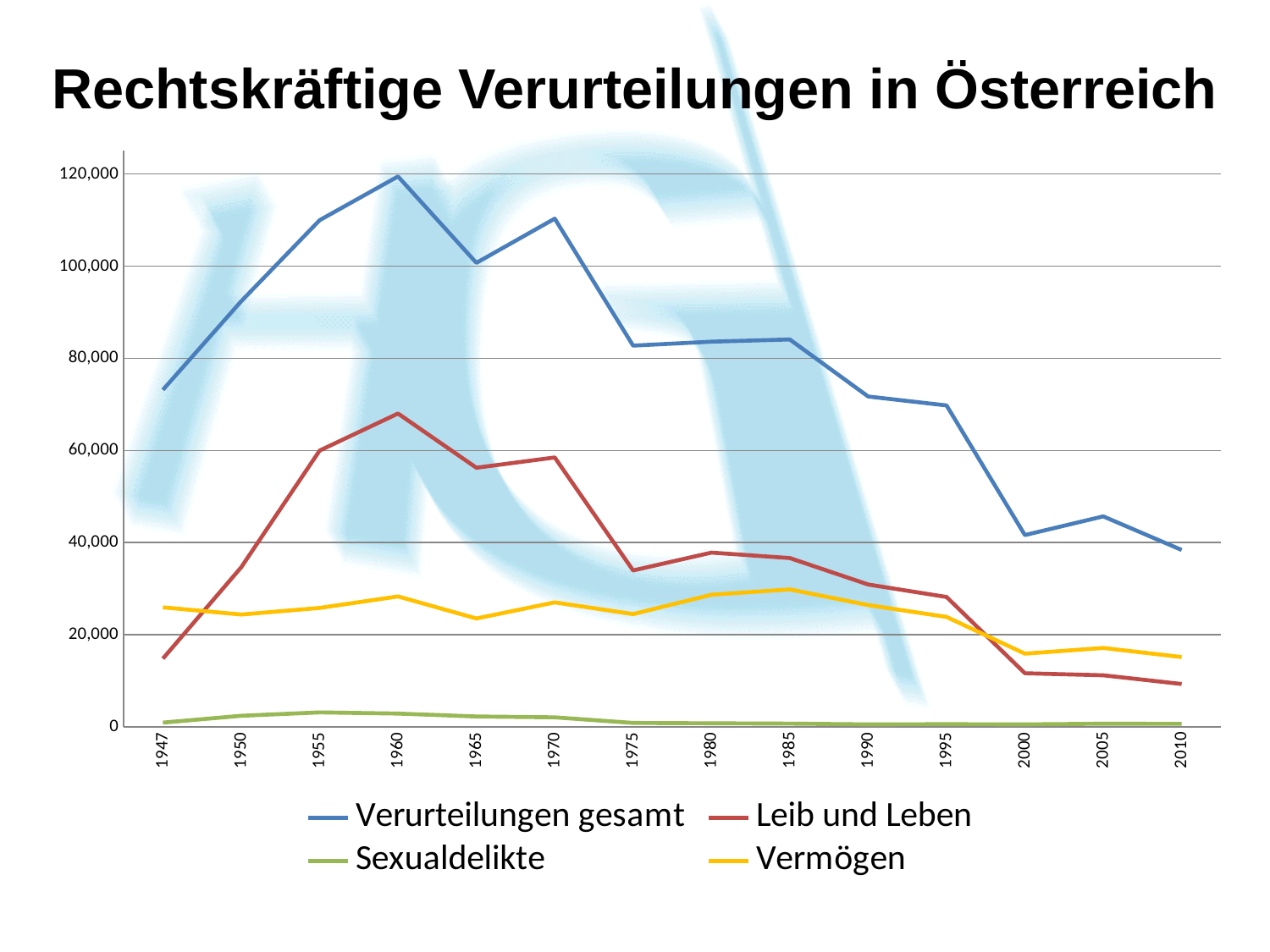
Does the Verurteilungen gesamt series rise or fall between 1960 and 2010? fall In which year does the Leib und Leben series reach its highest value? 1960 Is the value for Verurteilungen gesamt in 1947 greater or less than 80,000? less How many years are marked on the x axis? 14 What kind of chart is shown on the slide? line chart In which year does the Verurteilungen gesamt series reach its highest value? 1960 Which series is higher in 2005, Leib und Leben or Vermögen? Vermögen Is the value for Leib und Leben in 2010 greater or less than 20,000? less What is the title of the chart? Rechtskräftige Verurteilungen in Österreich How many series does the legend list? 4 Is the value for Verurteilungen gesamt in 1970 greater or less than 100,000? greater Which series is higher in 1985, Leib und Leben or Vermögen? Leib und Leben